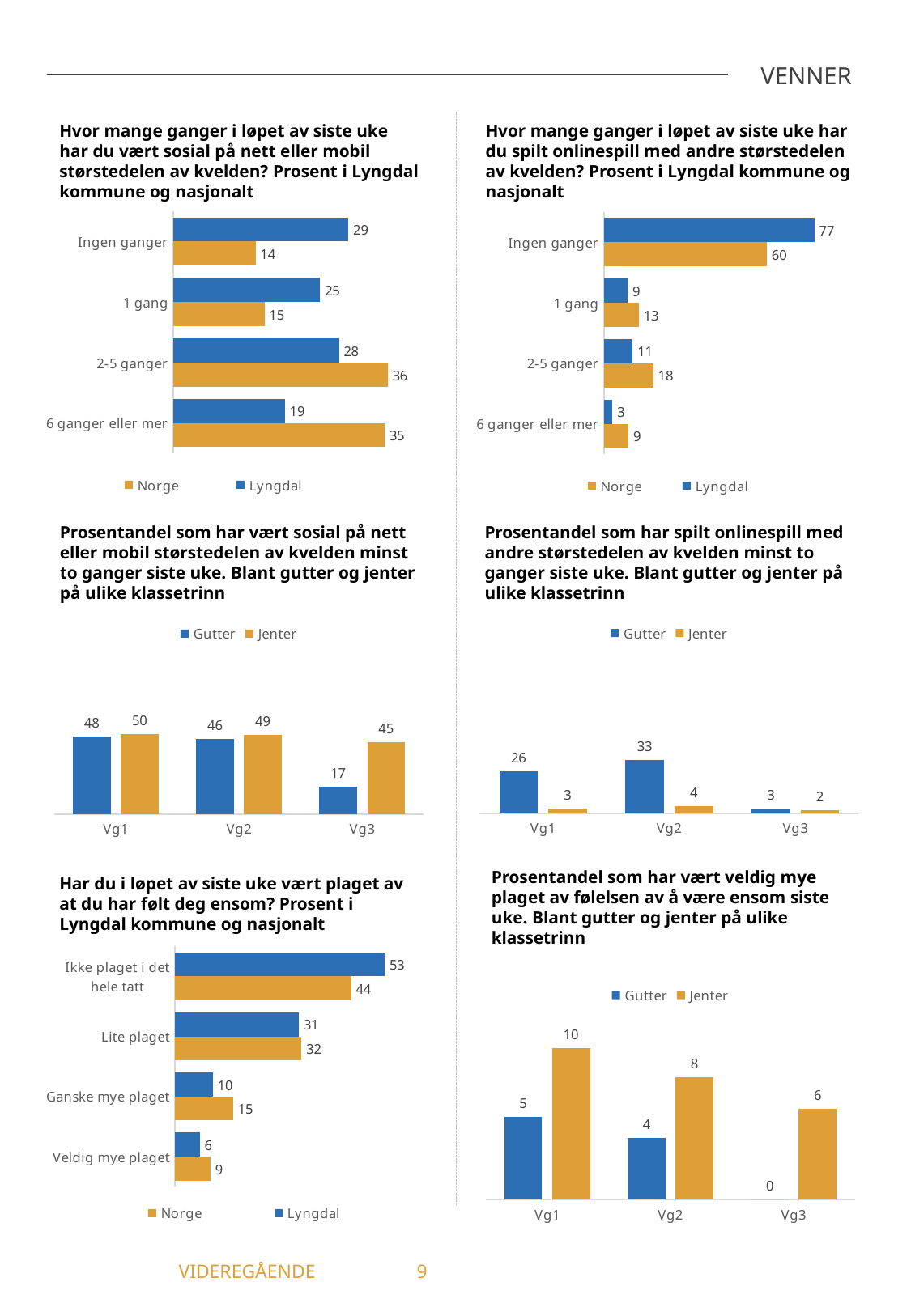
In the bottom-left chart about feeling lonely last week, how many categories are shown? 4 In the bottom-right chart about being very bothered by loneliness by grade, what is the value for Gutter at Vg3? 0 In the middle-right chart about playing online games at least twice last week by grade, which grade has the highest value for Gutter? Vg2 In the top-right chart about playing online games with others, which category has the highest value for Lyngdal? Ingen ganger In the middle-left chart about being social online at least twice last week by grade, what is the value for Gutter at Vg3? 17 In the middle-right chart about playing online games at least twice last week by grade, what is the difference between Gutter and Jenter at Vg1? 23 In the middle-left chart about being social online at least twice last week by grade, how many series does the legend list? 2 In the top-left chart about being social online or on mobile, what is the difference between Norge and Lyngdal for '6 ganger eller mer'? 16 In the bottom-left chart about feeling lonely last week, what is the value for Norge for 'Ganske mye plaget'? 15 In the top-right chart about playing online games with others, what is the value for Norge for '2-5 ganger'? 18 In the top-left chart about being social online or on mobile most of the evening, what is the value for Lyngdal for 'Ingen ganger'? 29 In the top-right chart about playing online games with others, which is larger for '1 gang': Norge or Lyngdal? Norge